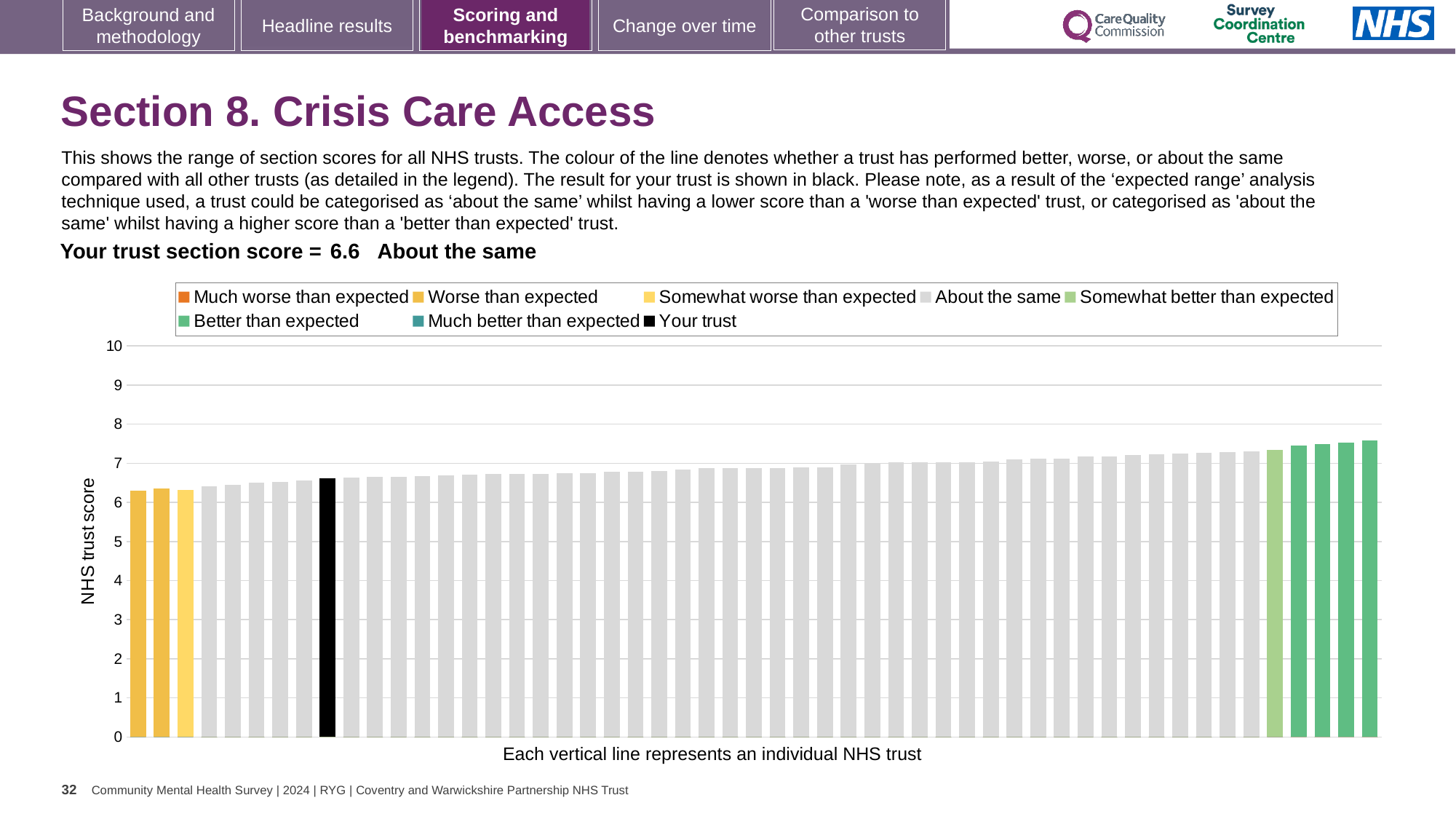
What kind of chart is shown on the slide? bar chart How many green bars (somewhat better or better than expected) are there in the chart? 5 Is the value of the rightmost bar greater or less than 7? greater How many yellow bars (worse than expected or somewhat worse than expected) are there in the chart? 3 What colour is the bar representing your trust? black Do the bar values rise or fall from left to right along the x axis? rise What is the label on the vertical axis of the chart? NHS trust score Which bar is higher, the leftmost bar or the rightmost bar? the rightmost bar How many entries does the chart legend list? 8 Is the value of the leftmost bar greater or less than 7? less What is the section score for your trust shown on the slide? 6.6 Is the value of the black bar (your trust) greater or less than 6? greater